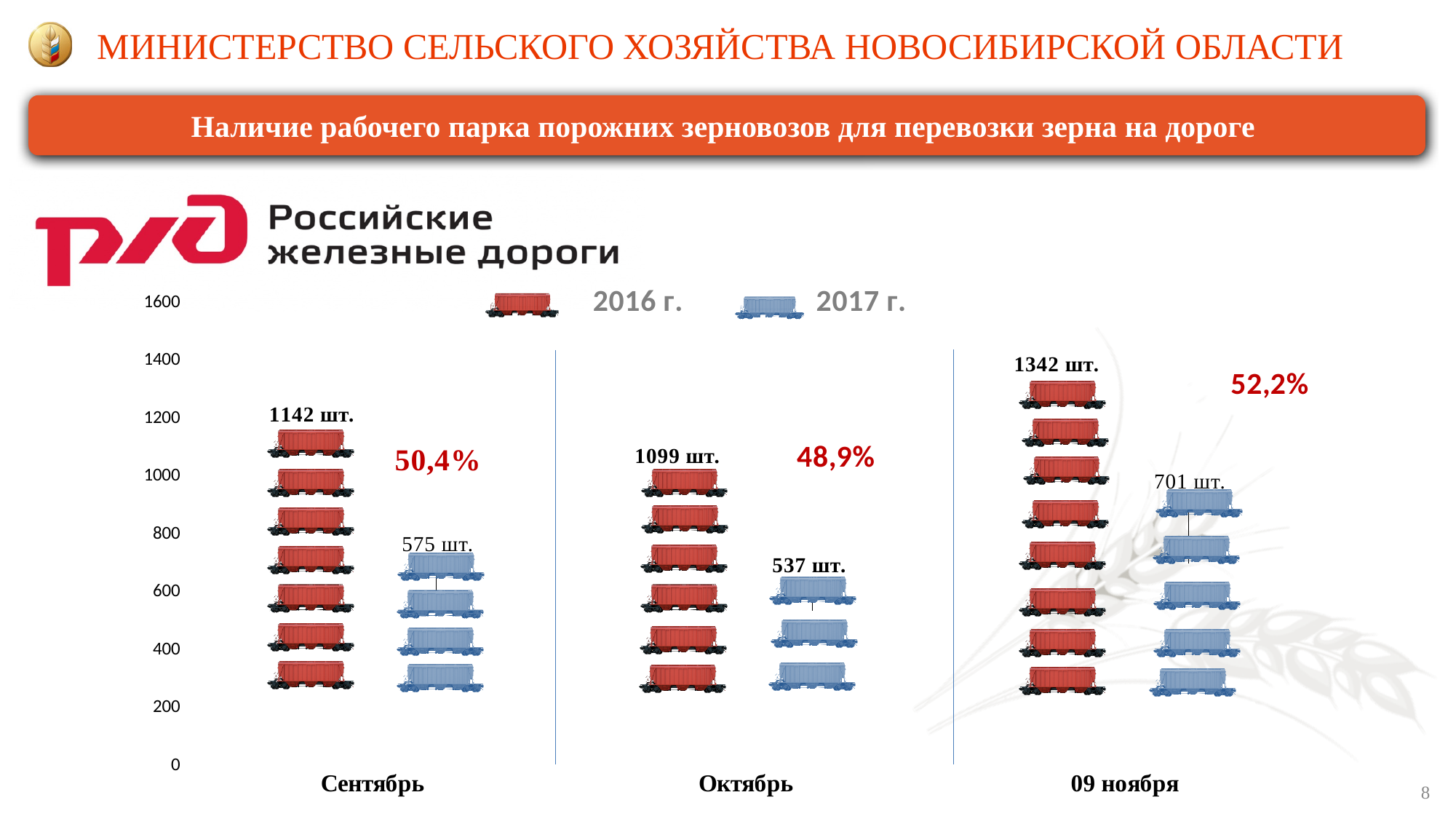
What percentage is shown for Октябрь? 48,9% What is the difference between the 2016 г. values on 09 ноября and in Октябрь? 243 шт. What is the difference between the 2016 г. and 2017 г. values in Сентябрь? 567 шт. Which is larger: the 2017 г. value in Сентябрь or the 2017 г. value in Октябрь? Сентябрь In which period is the 2017 г. value lowest? Октябрь In which period is the 2016 г. value highest? 09 ноября What is the value for 2016 г. in Сентябрь? 1142 шт. What is the value for 2017 г. on 09 ноября? 701 шт. What is the value for 2017 г. in Октябрь? 537 шт. Which colour represents 2017 г. in the legend? Blue How many periods are shown on the x axis? 3 How many series does the legend list? 2